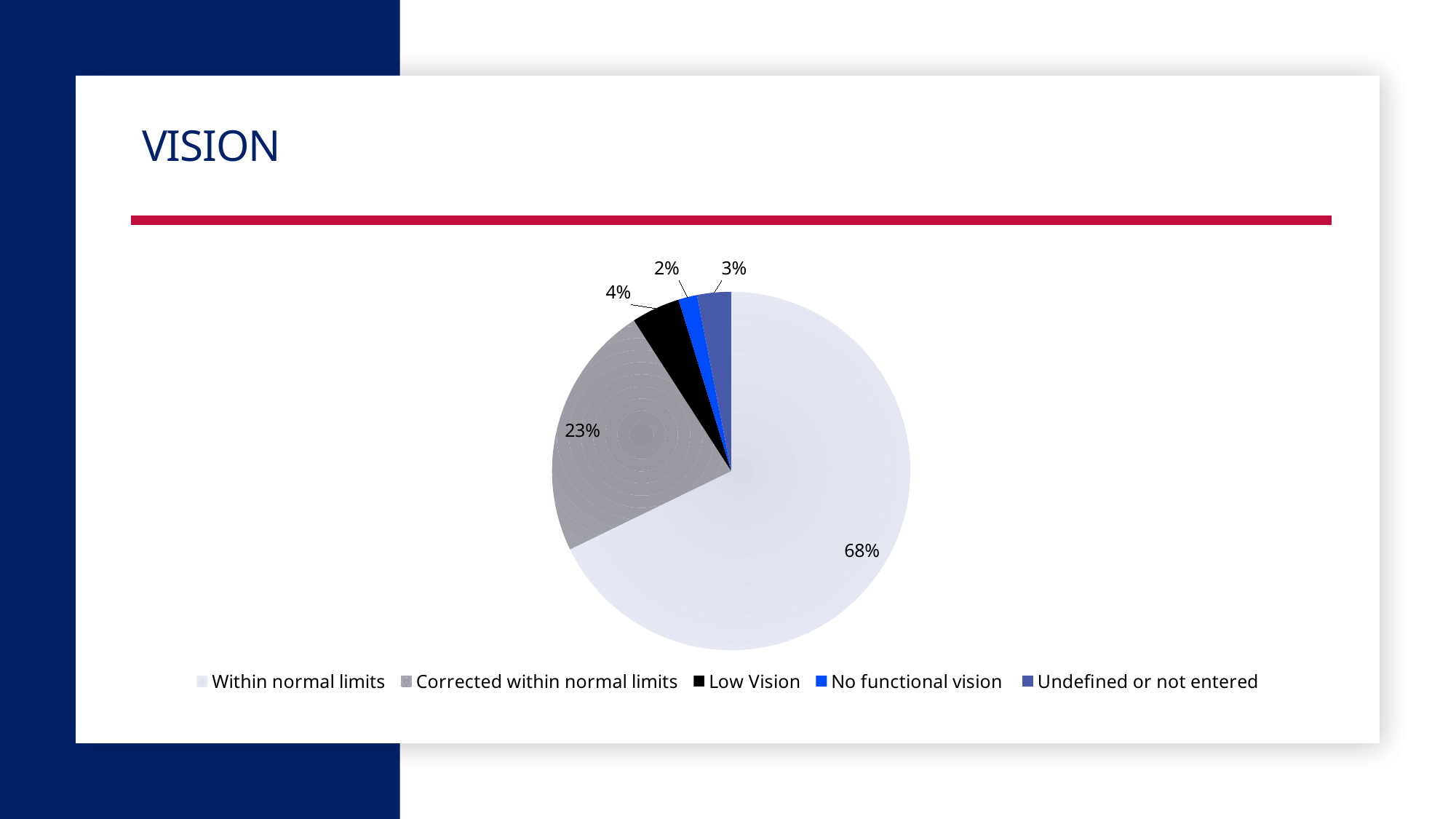
What kind of chart is shown on the slide? pie chart What is the difference between the Within normal limits share and the Corrected within normal limits share? 45% What share of the pie is labelled Low Vision? 4% What is the title of the slide containing the pie chart? VISION What share of the pie is labelled Undefined or not entered? 3% What share of the pie is labelled Corrected within normal limits? 23% How many categories does the pie chart show? 5 Which is larger, the Low Vision slice or the Undefined or not entered slice? Low Vision Which category has the smallest slice of the pie? No functional vision Which category has the largest slice of the pie? Within normal limits